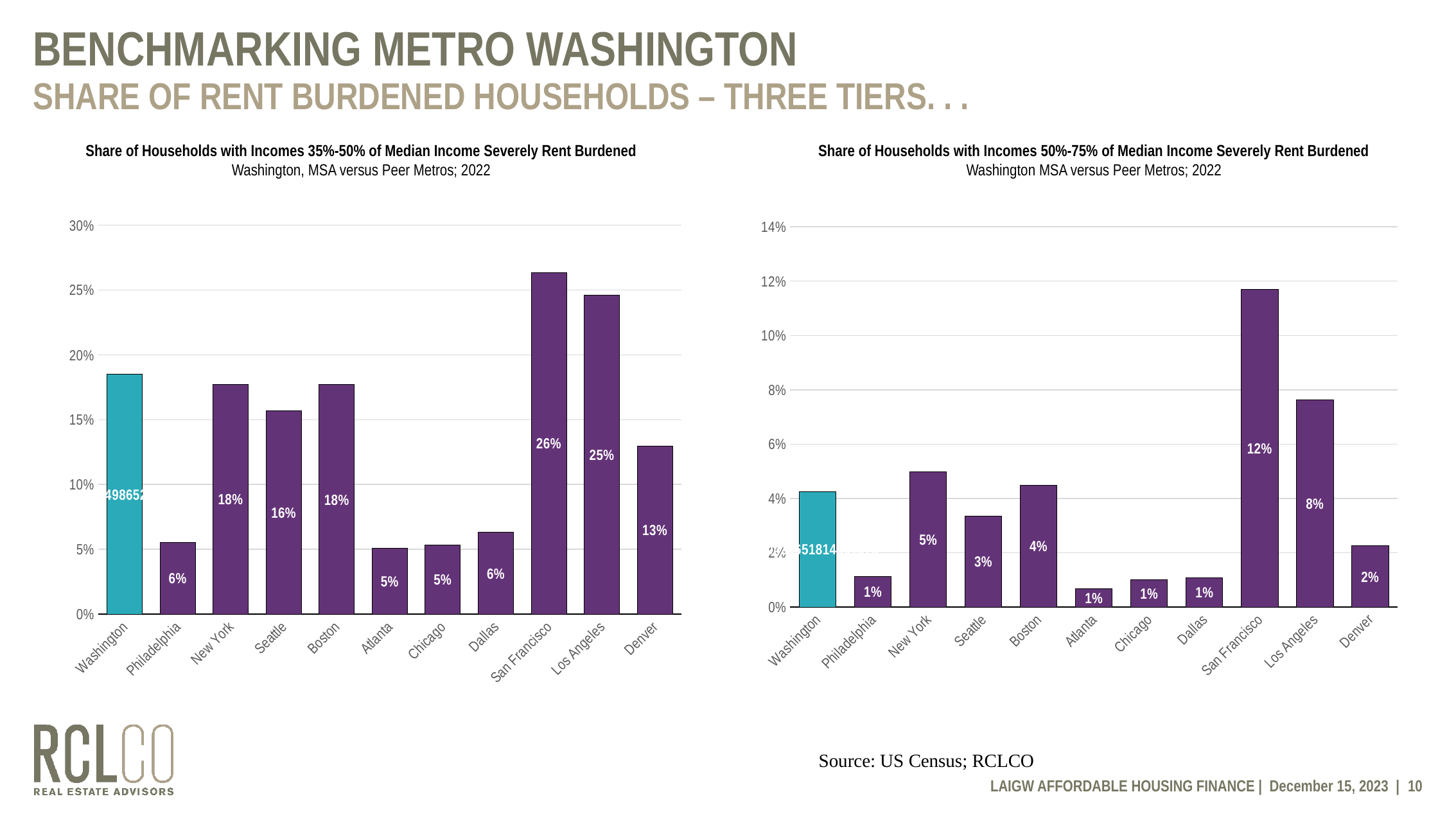
How many metros are shown in the right chart (Incomes 50%-75% of Median Income)? 11 What kind of chart is the left chart (Incomes 35%-50% of Median Income)? Bar chart In the left chart (Incomes 35%-50% of Median Income), what is the value for Denver? 13% In the left chart (Incomes 35%-50% of Median Income), is the value for Washington greater or less than 15%? greater In the left chart (Incomes 35%-50% of Median Income), what is the value for San Francisco? 26% In the right chart (Incomes 50%-75% of Median Income), which metro has the highest share? San Francisco In the right chart (Incomes 50%-75% of Median Income), what is the value for Boston? 4% In the right chart (Incomes 50%-75% of Median Income), what is the value for Los Angeles? 8% In the right chart (Incomes 50%-75% of Median Income), what is the difference between San Francisco and Los Angeles? 4% In the left chart (Incomes 35%-50% of Median Income), which is larger, New York or Seattle? New York In the left chart (Incomes 35%-50% of Median Income), which metro has the highest share? San Francisco In the left chart (Incomes 35%-50% of Median Income), what is the difference between San Francisco and Los Angeles? 1%